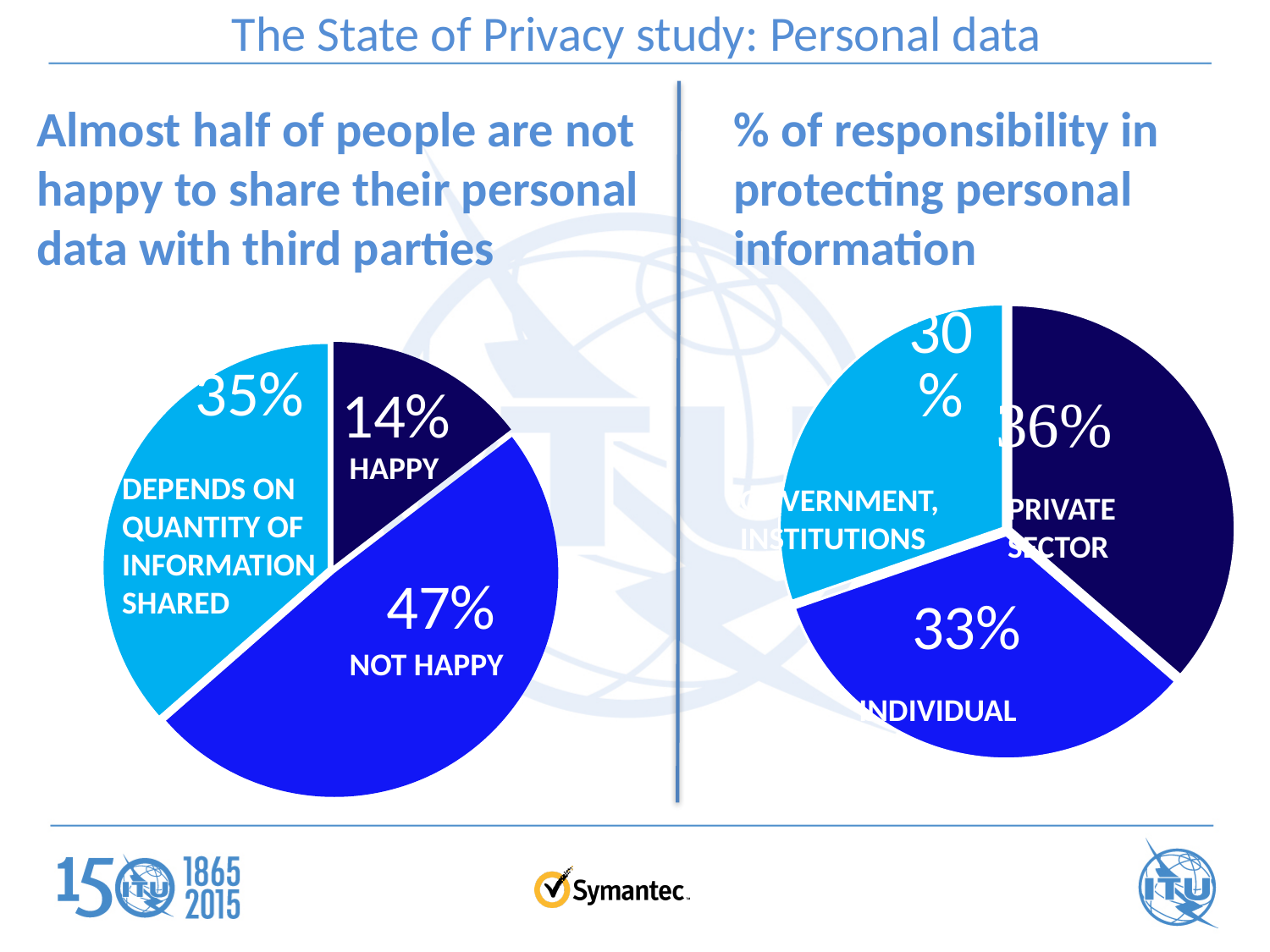
In the right pie chart, what percentage of responsibility is assigned to the individual? 33% In the left pie chart, what is the difference between the NOT HAPPY and HAPPY shares? 33% In the left pie chart, what percentage of people are happy to share their personal data? 14% In the right pie chart, which category has the largest share? PRIVATE SECTOR In the left pie chart, which category has the largest share? NOT HAPPY In the left pie chart, what percentage of people are not happy to share their personal data with third parties? 47% In the right pie chart, what percentage of responsibility for protecting personal information is assigned to the private sector? 36% In the left pie chart, which category has the smallest share? HAPPY In the left pie chart, what percentage say it depends on the quantity of information shared? 35% How many slices does the right pie chart have? 3 What type of chart is used on the left side of the slide? Pie chart In the right pie chart, what percentage of responsibility is assigned to government and institutions? 30%